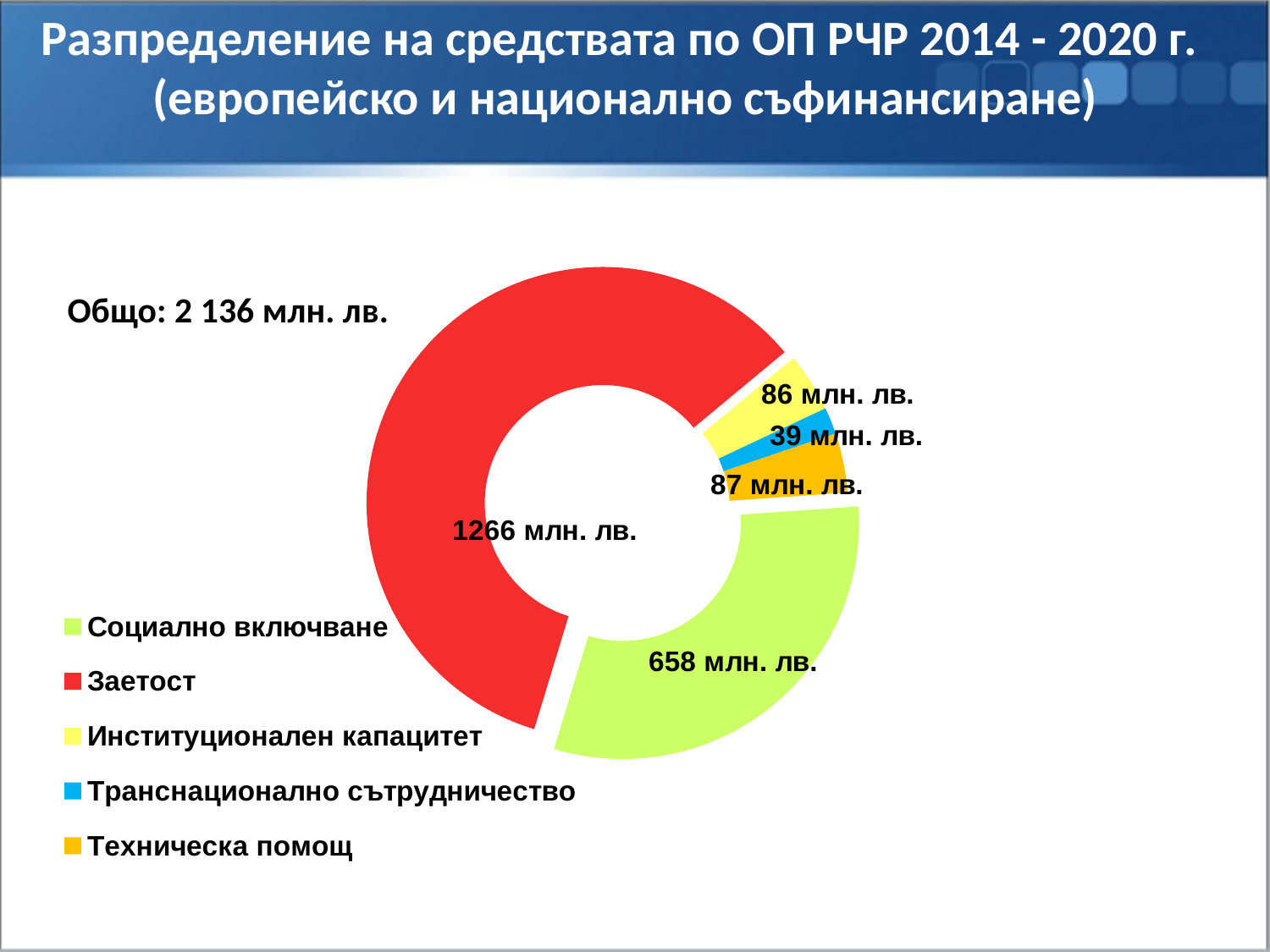
What is the difference between the values for Заетост and Социално включване? 608 млн. лв. Which category has the largest share of the funds? Заетост What total amount is stated on the slide? 2 136 млн. лв. How many categories does the chart show? 5 What is the value for Транснационално сътрудничество? 39 млн. лв. Which is larger, the value for Социално включване or the value for Техническа помощ? Социално включване Which category has the smallest share of the funds? Транснационално сътрудничество What is the value for Социално включване? 658 млн. лв. What is the value for Заетост? 1266 млн. лв. What is the value for Техническа помощ? 87 млн. лв. What is the value for Институционален капацитет? 86 млн. лв. What kind of chart is shown on the slide? doughnut chart